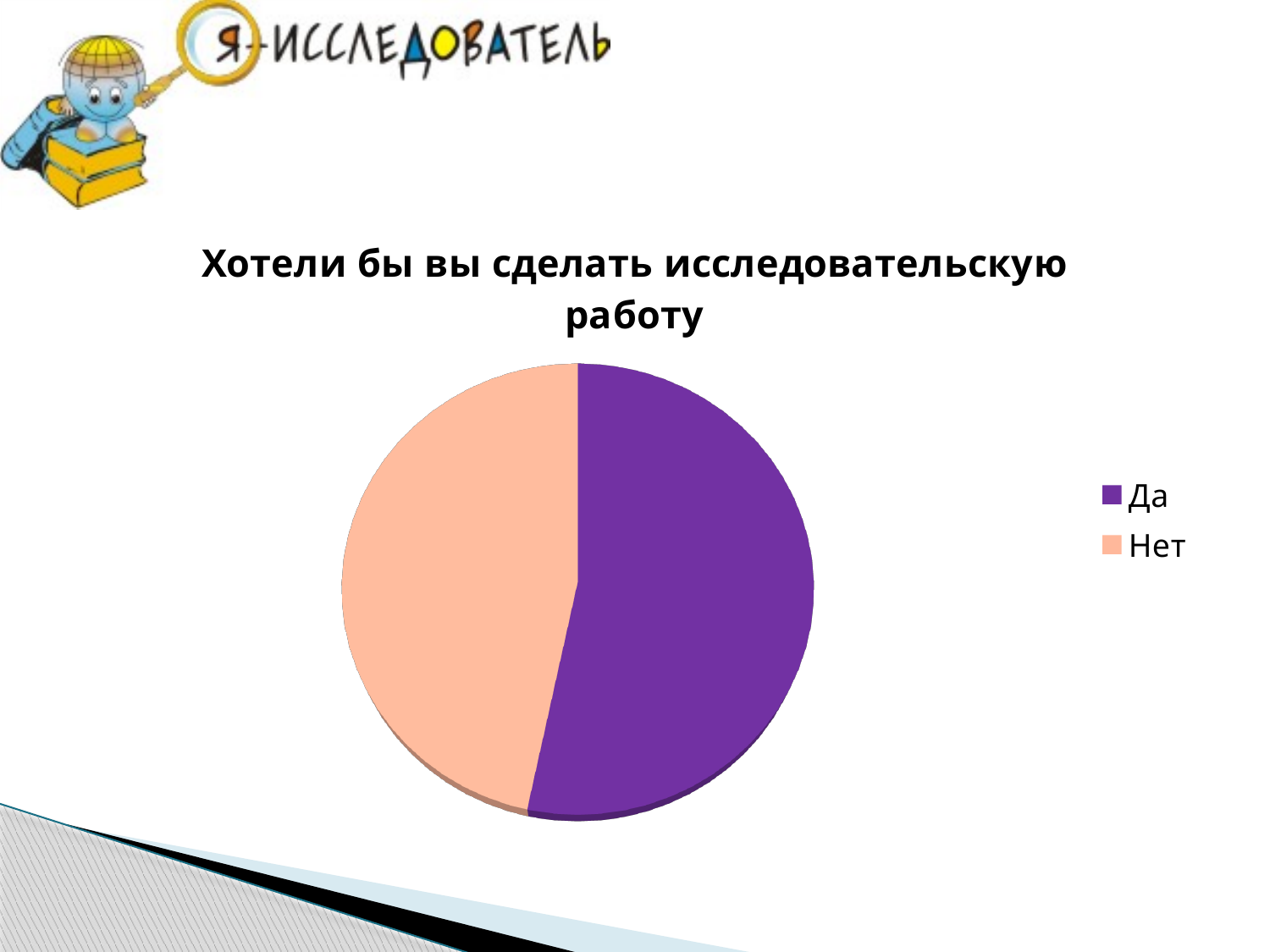
What is the title of the pie chart? Хотели бы вы сделать исследовательскую работу Which colour represents the "Да" slice in the pie chart? purple What kind of chart is shown on the slide? pie chart How many entries does the legend of the pie chart list? 2 Which slice is larger in the pie chart, "Да" or "Нет"? Да Which slice of the pie chart is the largest? Да Which slice of the pie chart is the smallest? Нет How many slices does the pie chart have? 2